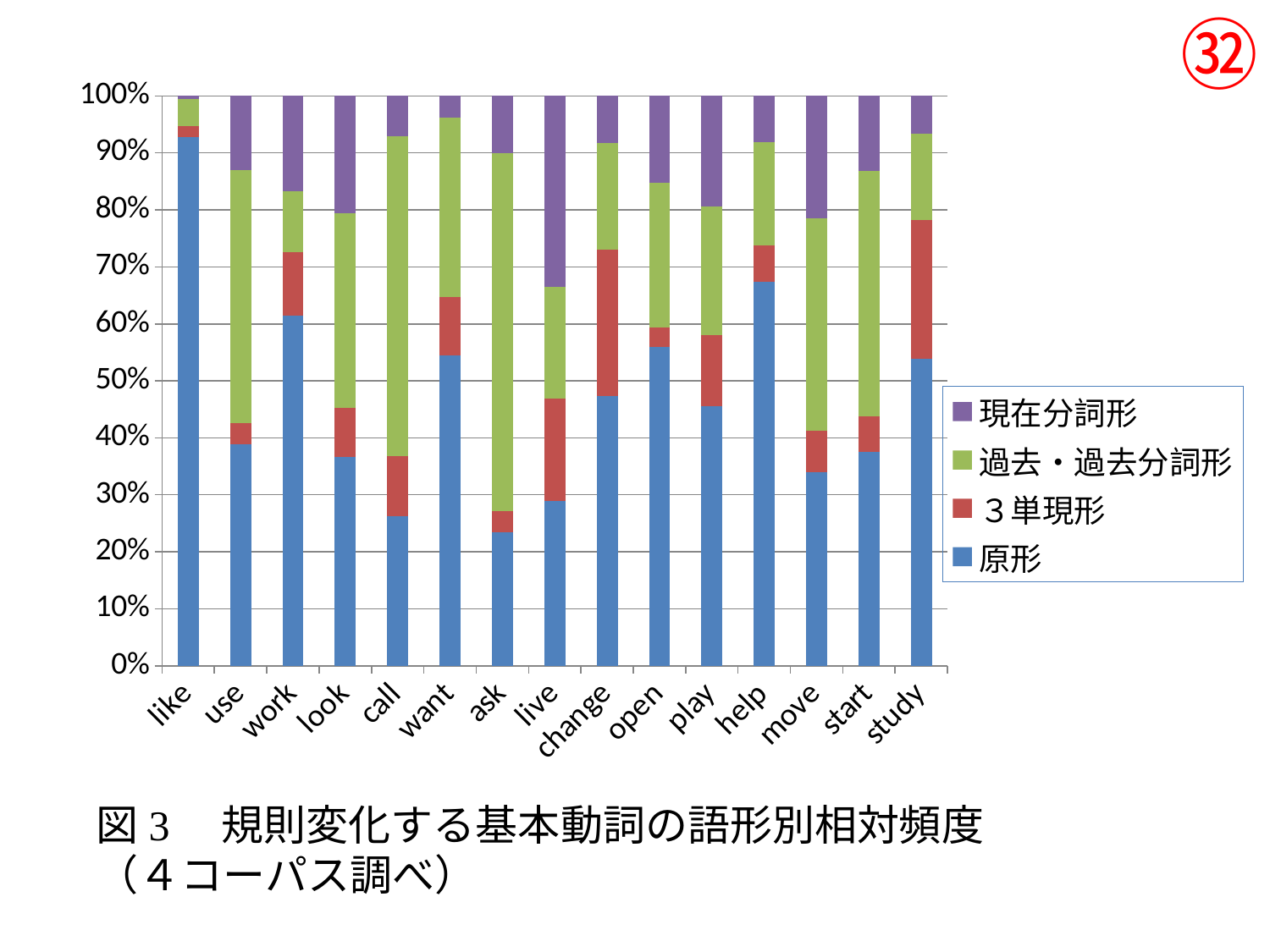
Which verb has the largest share of 現在分詞形? live What does each stacked bar total? 100% Which verb has the highest share of 原形? like Is the 原形 share for help greater or less than 60%? greater Which verb has the smallest share of 現在分詞形? like Is the 原形 share for like greater or less than 90%? greater What kind of chart is shown on the slide? stacked bar chart Which series is shown in blue in the legend? 原形 Which verb has a larger 原形 share, work or look? work How many verbs are shown along the x axis of the chart? 15 Is the 原形 share for ask greater or less than 30%? less How many series does the chart's legend list? 4